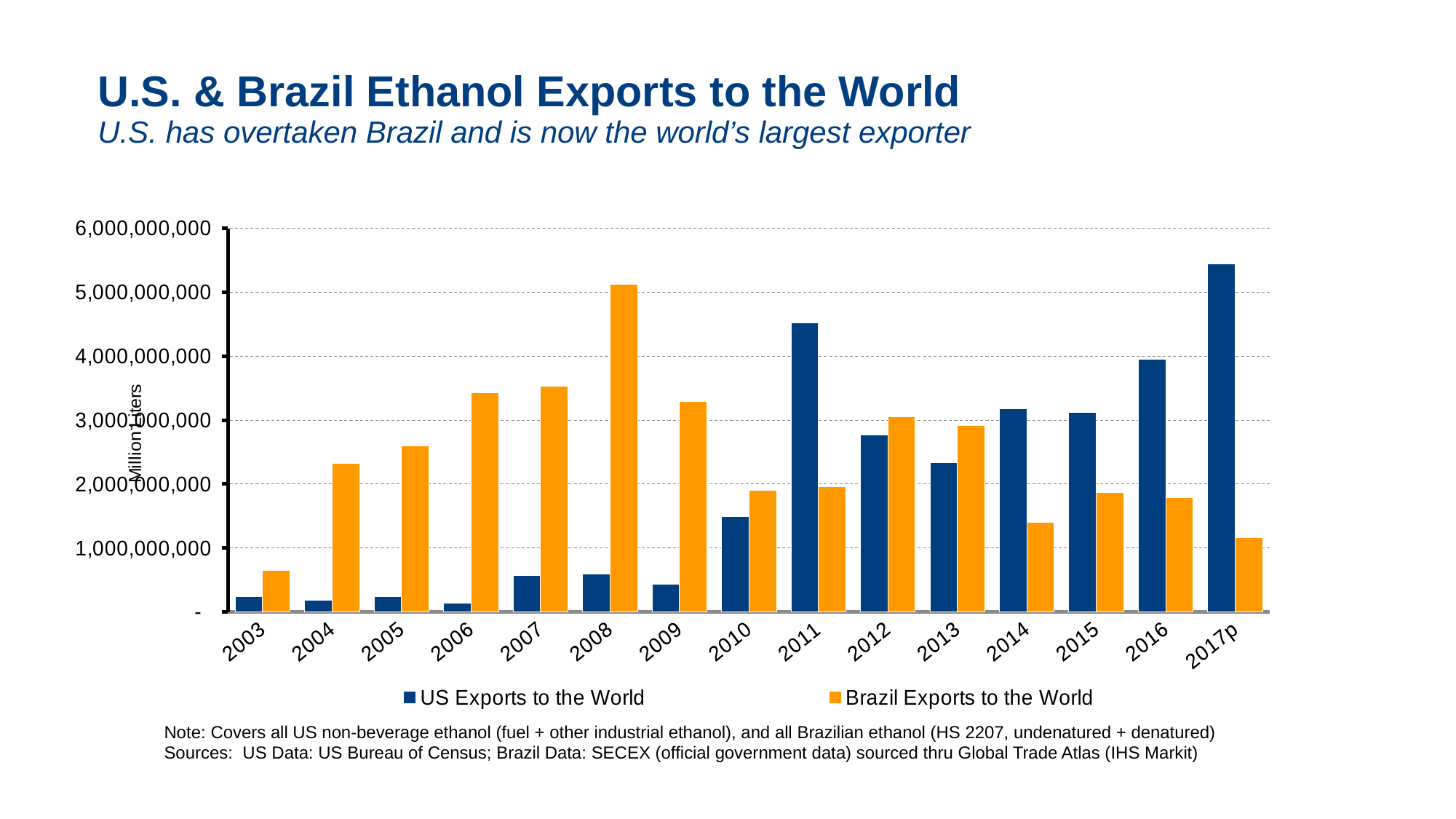
In 2012, which is larger: US Exports to the World or Brazil Exports to the World? Brazil Exports to the World How many series does the legend list? 2 Is the value for Brazil Exports to the World in 2017p greater or less than 2,000,000,000? less In 2014, which is larger: US Exports to the World or Brazil Exports to the World? US Exports to the World What colour are the bars for Brazil Exports to the World? orange Is the value for US Exports to the World in 2011 greater or less than 4,000,000,000? greater Is the value for Brazil Exports to the World in 2008 greater or less than 5,000,000,000? greater In which year are US Exports to the World highest? 2017p In which year are Brazil Exports to the World highest? 2008 What kind of chart is shown on the slide? bar chart In which year are Brazil Exports to the World lowest? 2003 How many years are shown on the x axis? 15